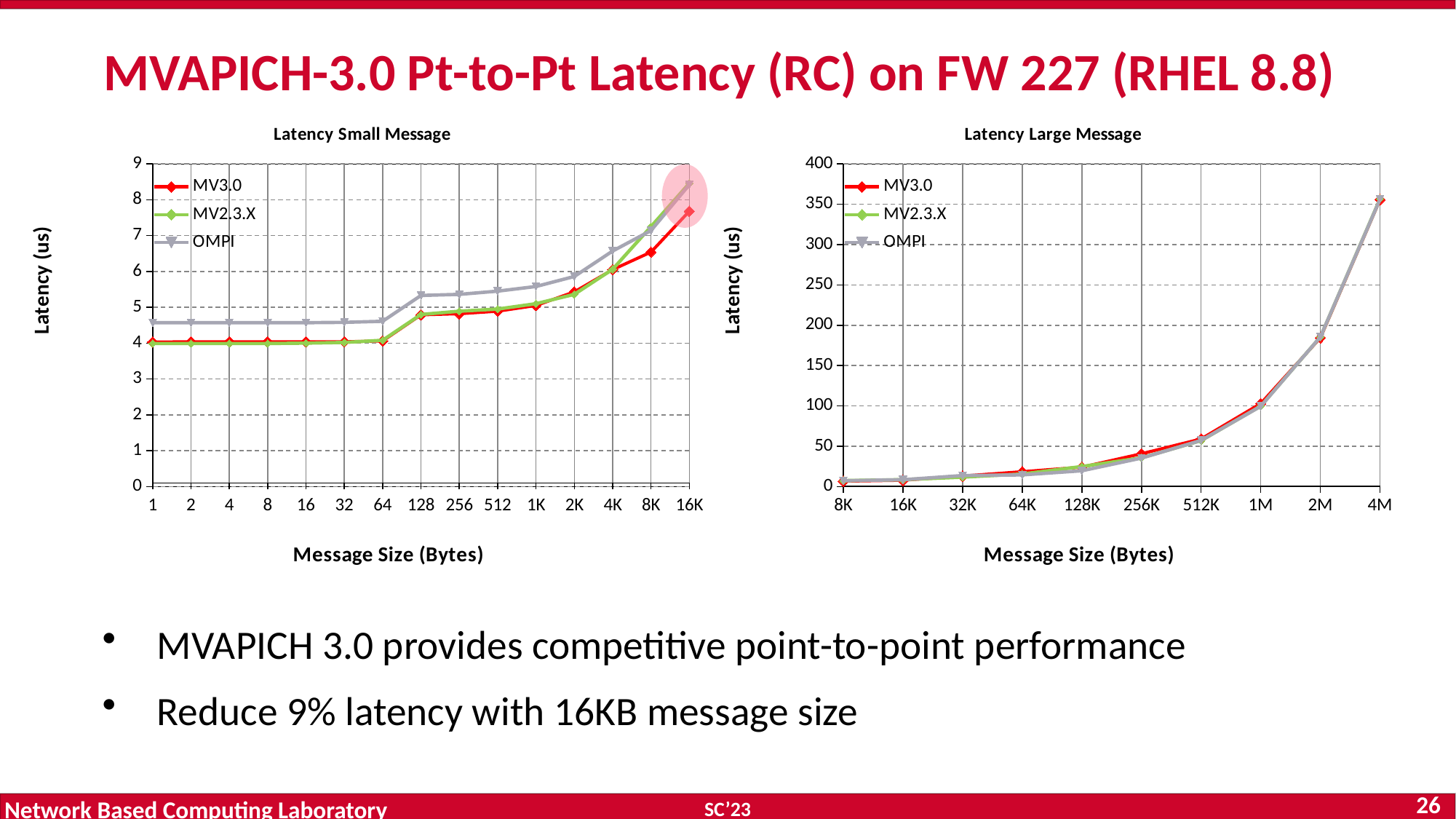
In the Latency Small Message chart, is the OMPI latency at message size 1 greater or less than 5? less In the Latency Large Message chart, do the latency values rise or fall as message size increases? rise How many message sizes are plotted on the x axis of the Latency Small Message chart? 15 In the Latency Small Message chart, is the MV3.0 latency at message size 128 greater or less than 5? less In the Latency Large Message chart, is the MV3.0 latency at message size 2M greater or less than 200? less How many message sizes are plotted on the x axis of the Latency Large Message chart? 10 What kind of chart is the Latency Small Message chart? line chart How many series does the legend of the Latency Large Message chart list? 3 In the Latency Small Message chart, at message size 1, which is larger: the OMPI latency or the MV3.0 latency? OMPI